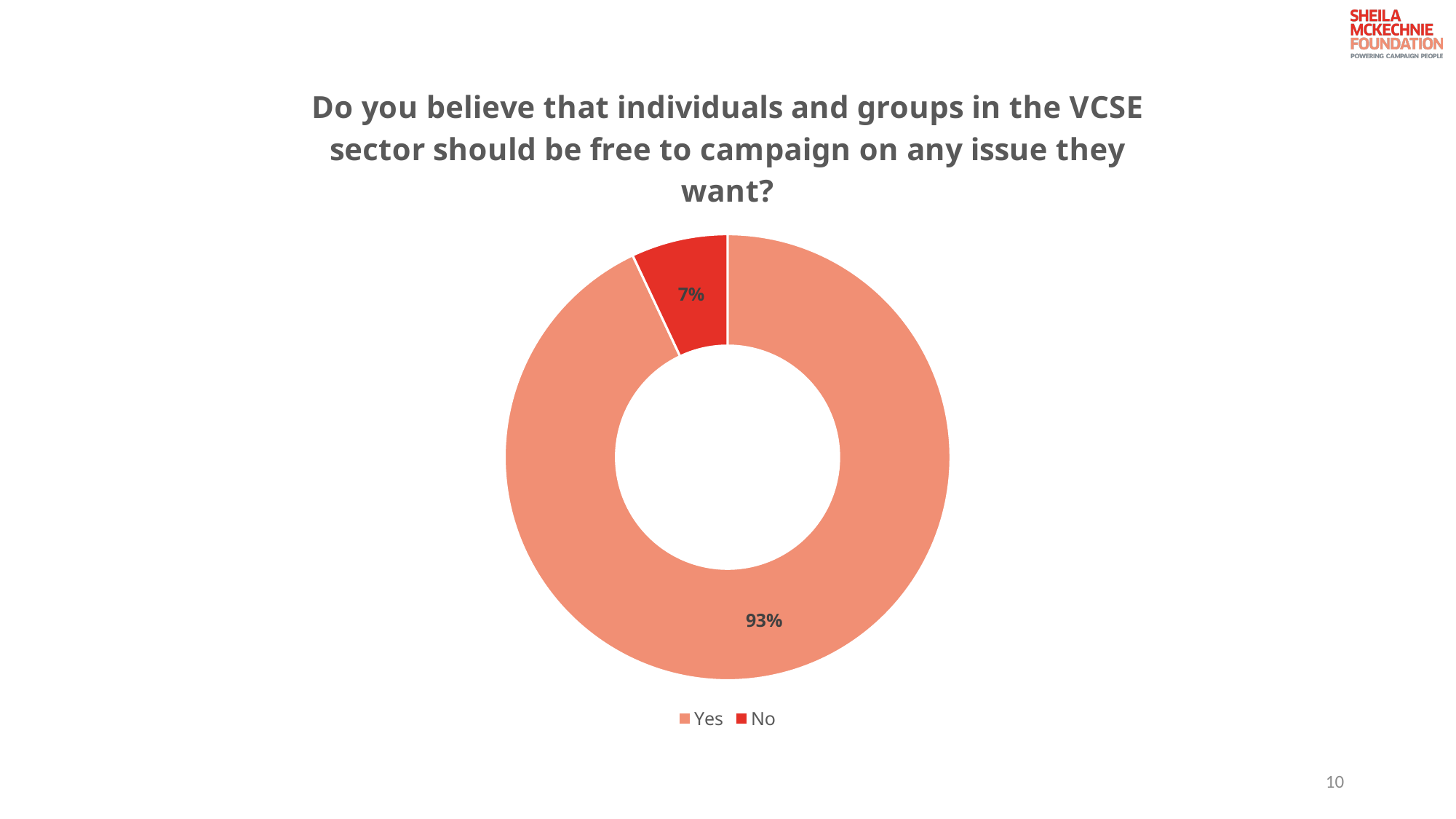
How many categories are shown in the chart? 2 Which response has the smallest share of the chart? No Which legend entry is shown in the darker red colour? No Which is larger, the share for Yes or the share for No? Yes What percentage of respondents answered No? 7% What kind of chart is shown on the slide? Doughnut (pie) chart What is the title of the chart? Do you believe that individuals and groups in the VCSE sector should be free to campaign on any issue they want? What is the difference in percentage points between the Yes and No shares? 86 Which response has the largest share of the chart? Yes What percentage of respondents answered Yes? 93% How many entries does the legend list? 2 What share of the chart does the Yes slice represent? 93%